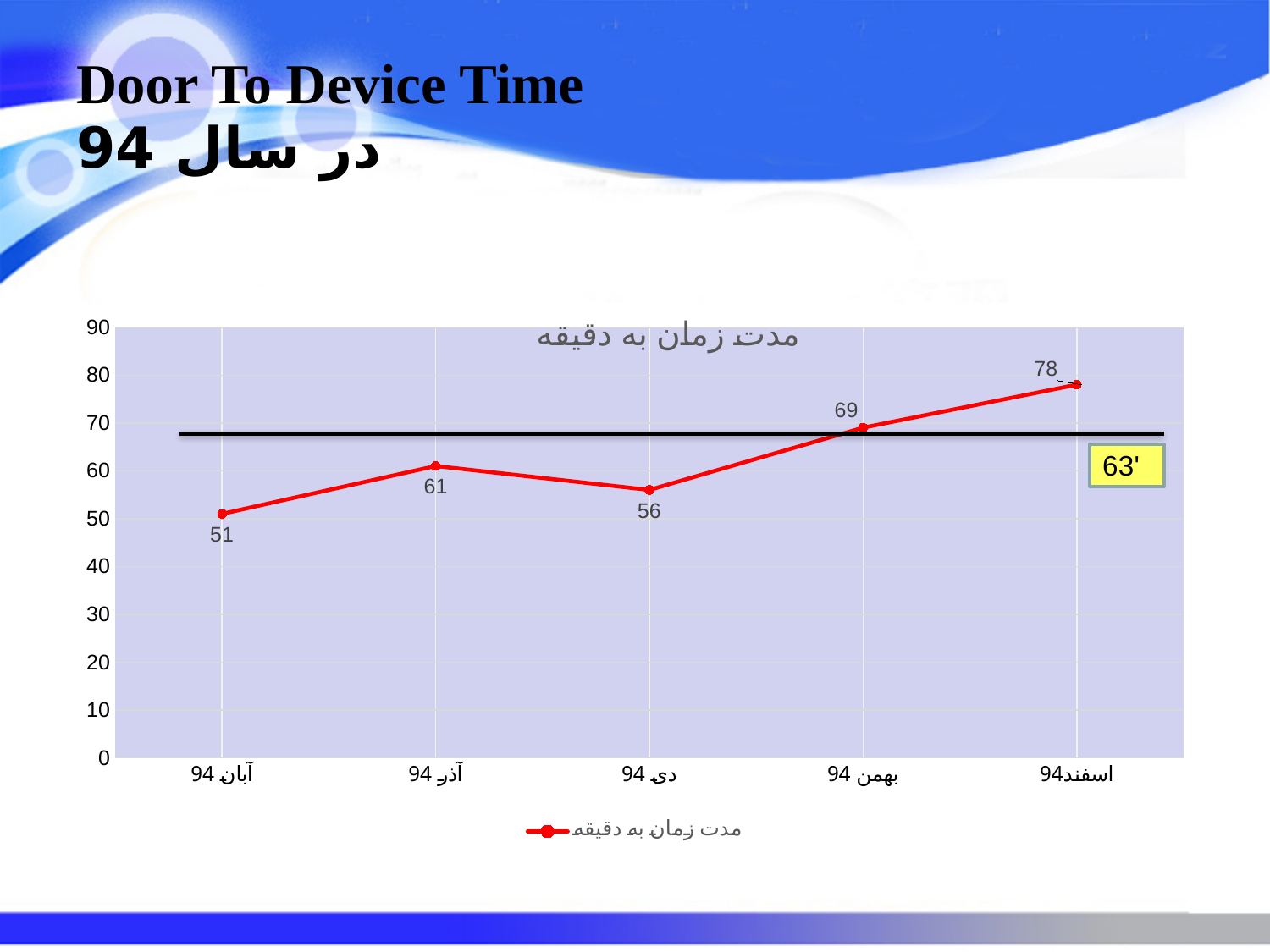
Which month has the lowest value? آبان 94 What is the value for آذر 94? 61 What is the difference between the values for اسفند94 and آبان 94? 27 Which is larger, the value for آذر 94 or the value for دی 94? آذر 94 What type of chart is shown on the slide? line chart Which month has the highest value? اسفند94 How many data points are plotted on the line? 5 What is the title of the chart? مدت زمان به دقیقه What is the value for دی 94? 56 What is the value for اسفند94? 78 What is the value for آبان 94? 51 What is the value for بهمن 94? 69